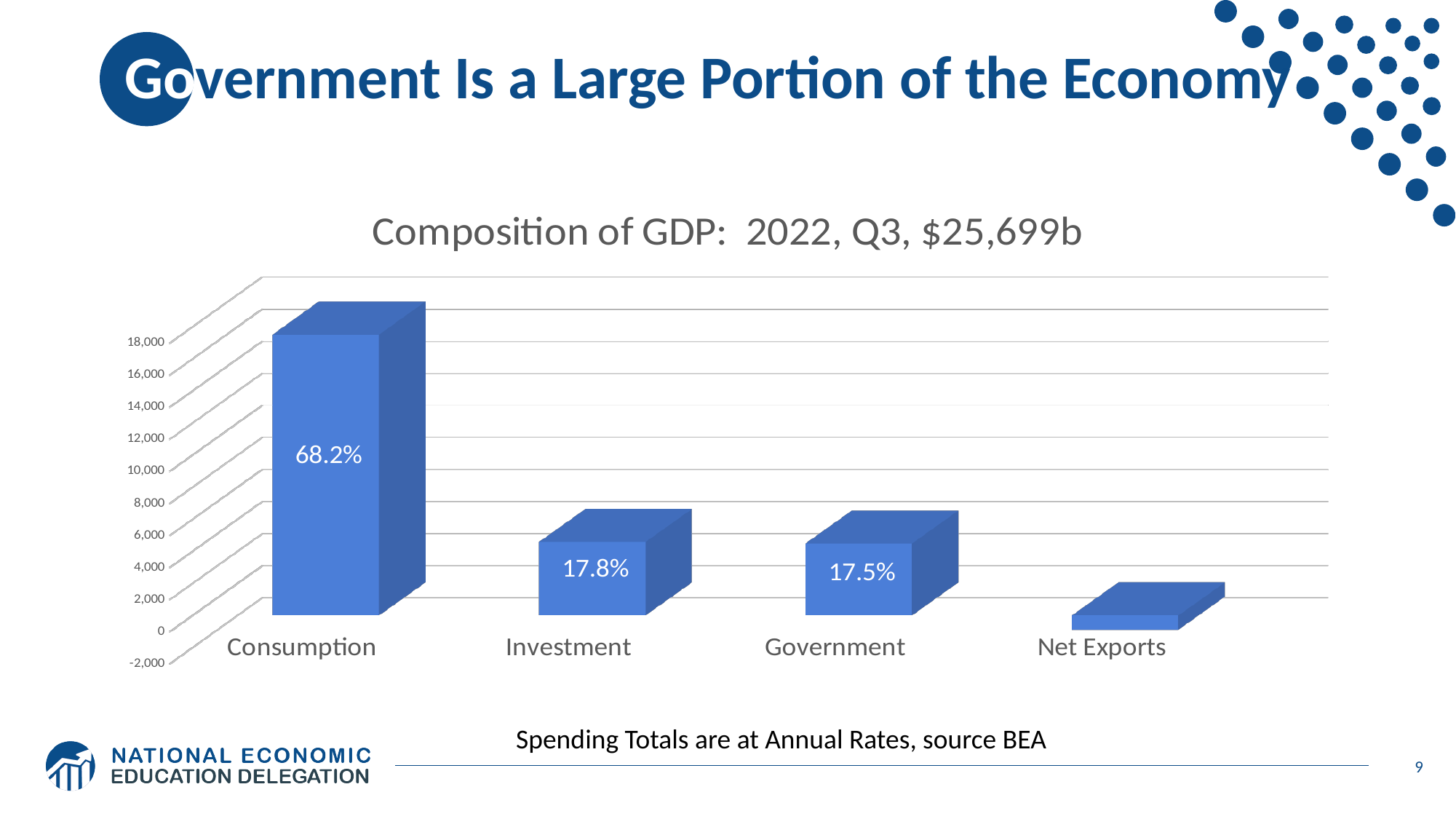
How many categories are shown on the chart? 4 Which category has the tallest bar? Consumption What is the difference between the Investment and Government percentage labels? 0.3% What is the title of the chart? Composition of GDP: 2022, Q3, $25,699b What percentage label is shown on the Government bar? 17.5% What percentage label is shown on the Investment bar? 17.8% Is the value for Consumption greater or less than 10,000? greater What percentage label is shown on the Consumption bar? 68.2% Which category has the lowest bar? Net Exports Is the value for Net Exports greater or less than 2,000? less Which has the larger percentage label, Investment or Government? Investment What is the difference between the Consumption and Investment percentage labels? 50.4%